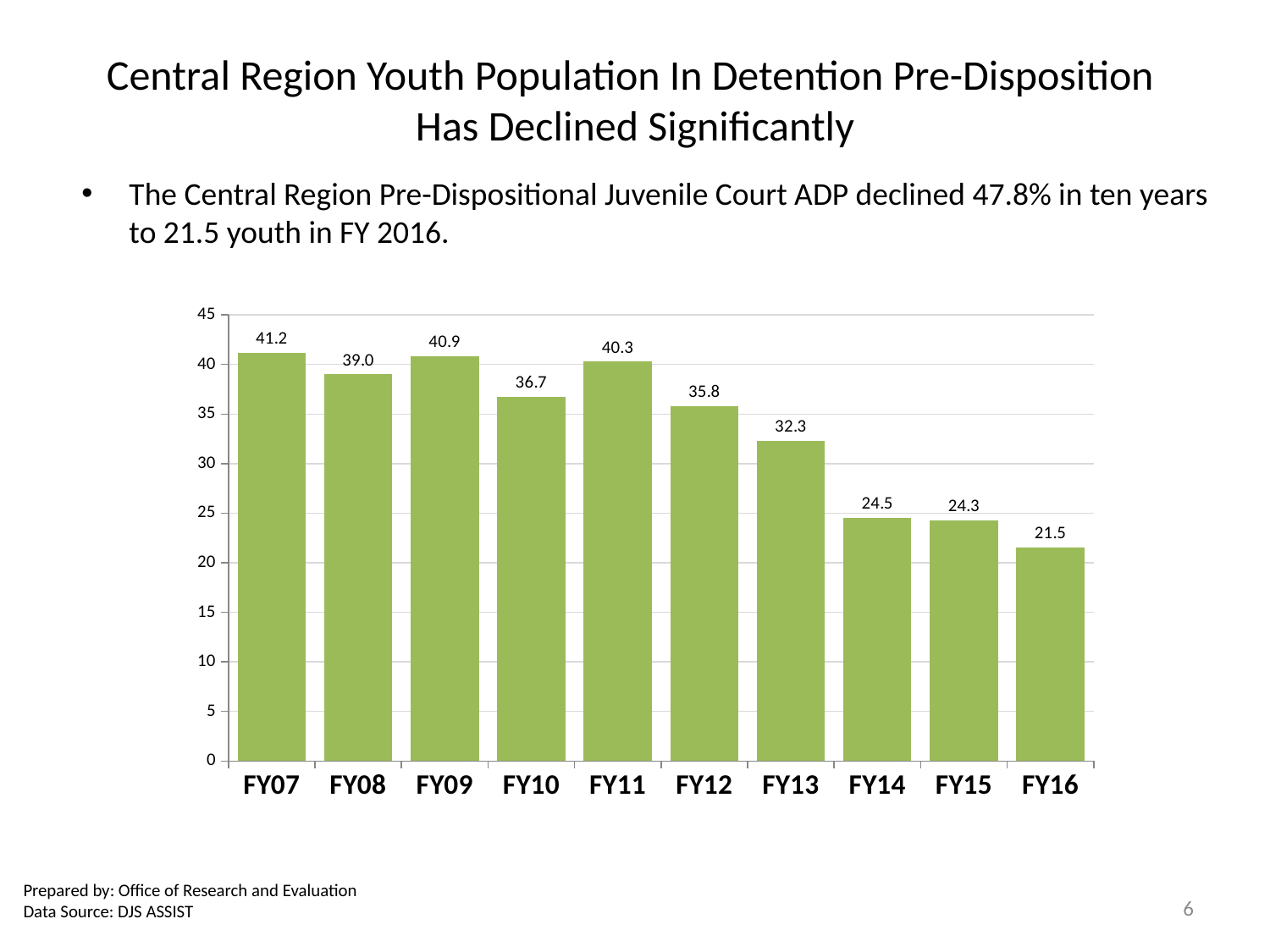
Do the values generally rise or fall from FY07 to FY16? fall What is the value for FY16? 21.5 Is the value for FY12 greater or less than 35? greater How many fiscal years are shown on the x axis? 10 What is the value for FY13? 32.3 Which fiscal year has the highest value? FY07 What kind of chart is shown on the slide? bar chart What is the difference between the values for FY13 and FY14? 7.8 Which is larger, the value for FY10 or the value for FY11? FY11 What is the value for FY07? 41.2 Which fiscal year has the lowest value? FY16 What is the difference between the values for FY07 and FY16? 19.7